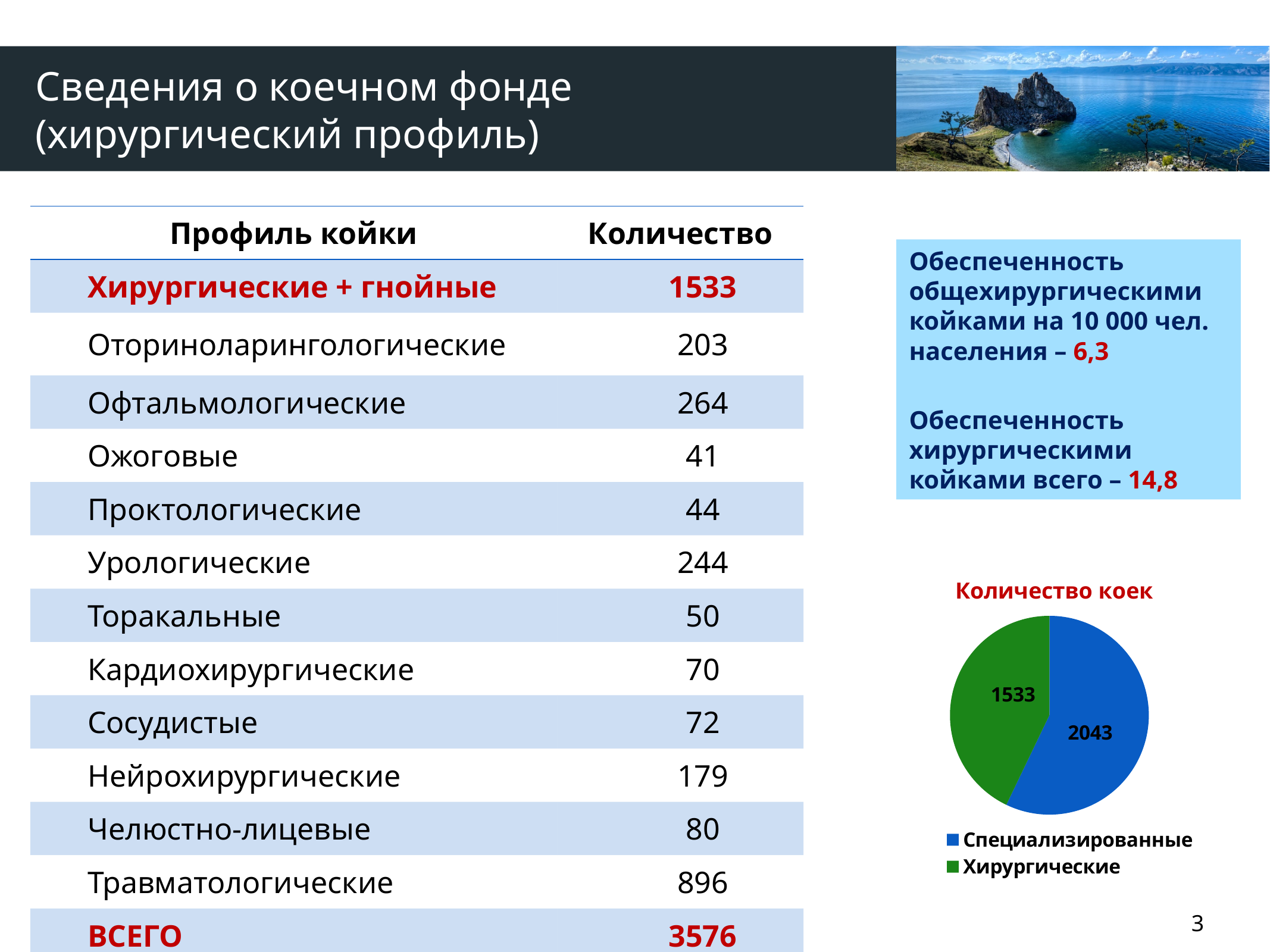
Which slice of the pie chart "Количество коек" is the smallest? Хирургические What is the total of the two slices in the pie chart "Количество коек"? 3576 In the pie chart "Количество коек", what colour is the Хирургические slice? green What is the title of the pie chart on the slide? Количество коек In the pie chart "Количество коек", which is larger: Специализированные or Хирургические? Специализированные What kind of chart is shown on the slide under the title "Количество коек"? pie chart In the pie chart "Количество коек", what is the value for Хирургические? 1533 In the pie chart "Количество коек", what is the difference between Специализированные and Хирургические? 510 In the pie chart "Количество коек", what is the value for Специализированные? 2043 How many entries does the legend of the pie chart "Количество коек" list? 2 How many slices does the pie chart "Количество коек" have? 2 Which slice of the pie chart "Количество коек" is the largest? Специализированные